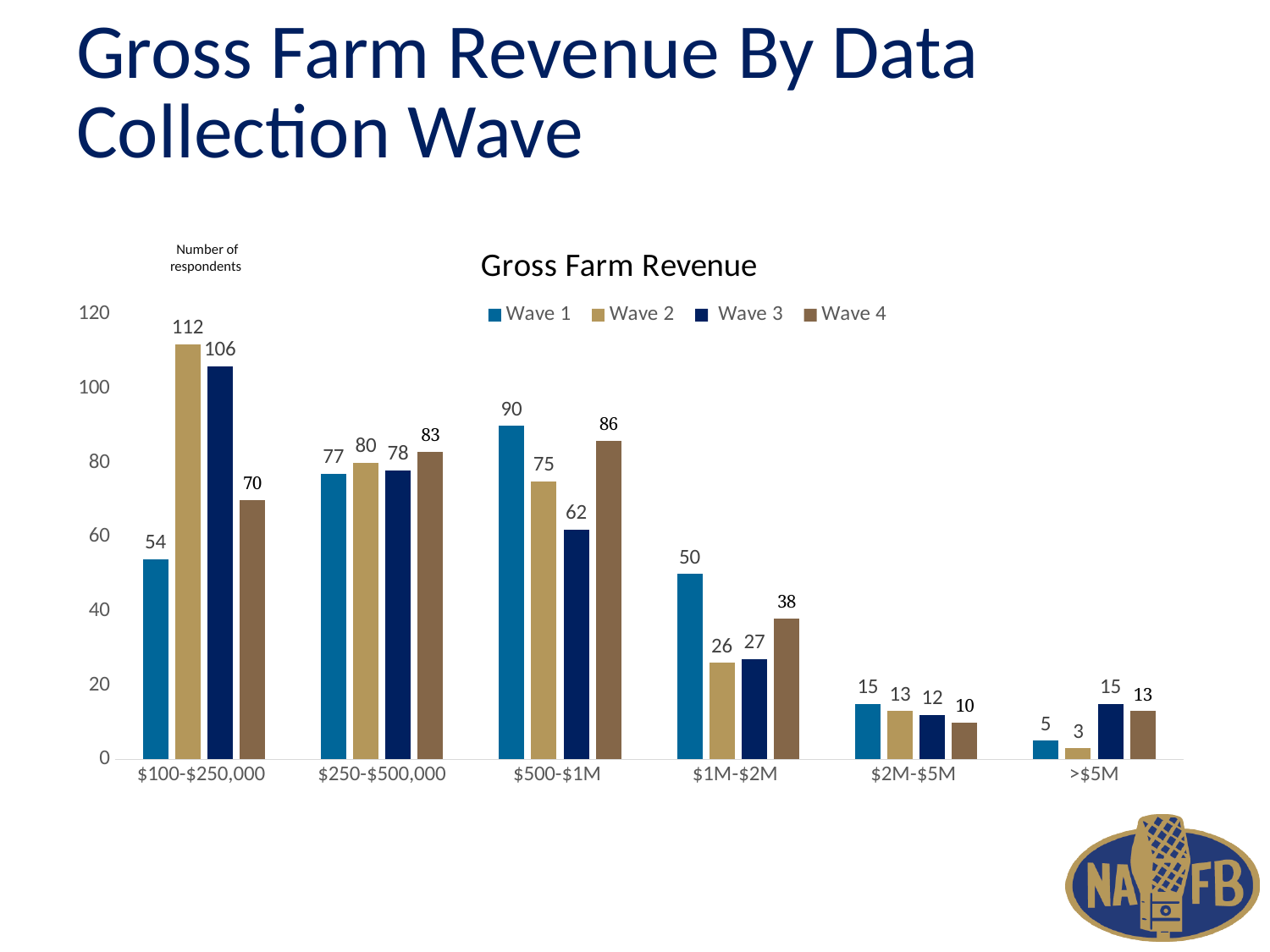
What kind of chart is shown on the slide? bar chart How many revenue categories are shown on the x axis? 6 What is the difference between the Wave 2 and Wave 4 values for the $100-$250,000 category? 42 What is the title of the chart? Gross Farm Revenue Is the Wave 3 value for the $500-$1M category greater or less than 80? less What is the Wave 2 value for the $100-$250,000 category? 112 What is the Wave 4 value for the $500-$1M category? 86 Which category has the lowest Wave 2 value? >$5M How many series does the legend list? 4 What is the Wave 1 value for the $1M-$2M category? 50 Which category has the highest Wave 1 value? $500-$1M Which is larger for the $250-$500,000 category: Wave 1 or Wave 4? Wave 4